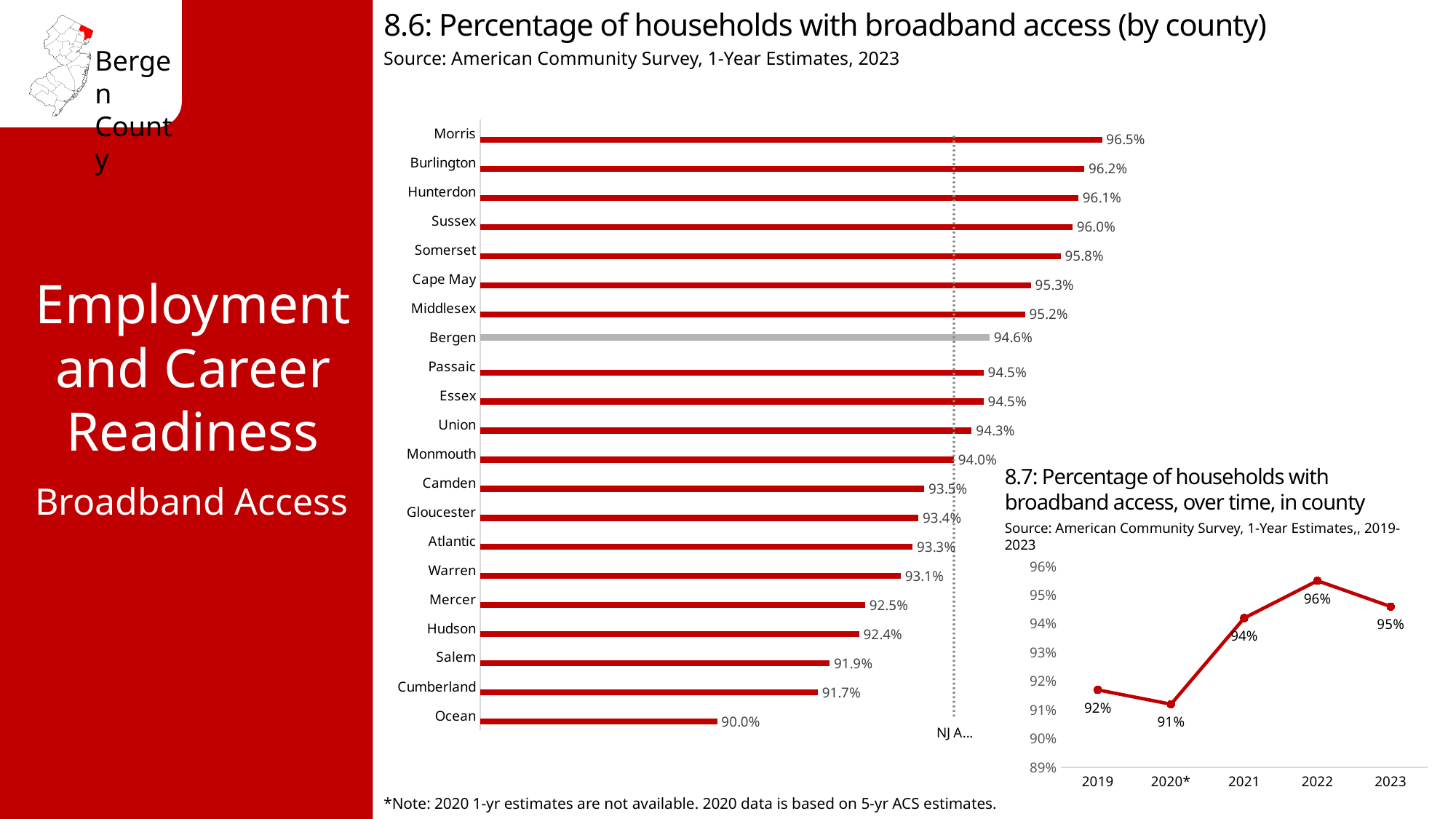
In chart 8.6, what is the difference between the values for Morris and Ocean? 6.5 percentage points In chart 8.7, how many data points are plotted? 5 What type of chart is chart 8.7? Line chart In chart 8.6, what is the percentage of households with broadband access in Bergen County? 94.6% In chart 8.6, what is the value for Cumberland? 91.7% In chart 8.6, which county has the lowest percentage of households with broadband access? Ocean In chart 8.6, which county has the highest percentage of households with broadband access? Morris What type of chart is chart 8.6? Bar chart In chart 8.6, which county has a higher value, Hudson or Mercer? Mercer In chart 8.6, how many counties are shown? 21 In chart 8.7, which year has the lowest value? 2020* In chart 8.7, what is the value for 2022? 96%